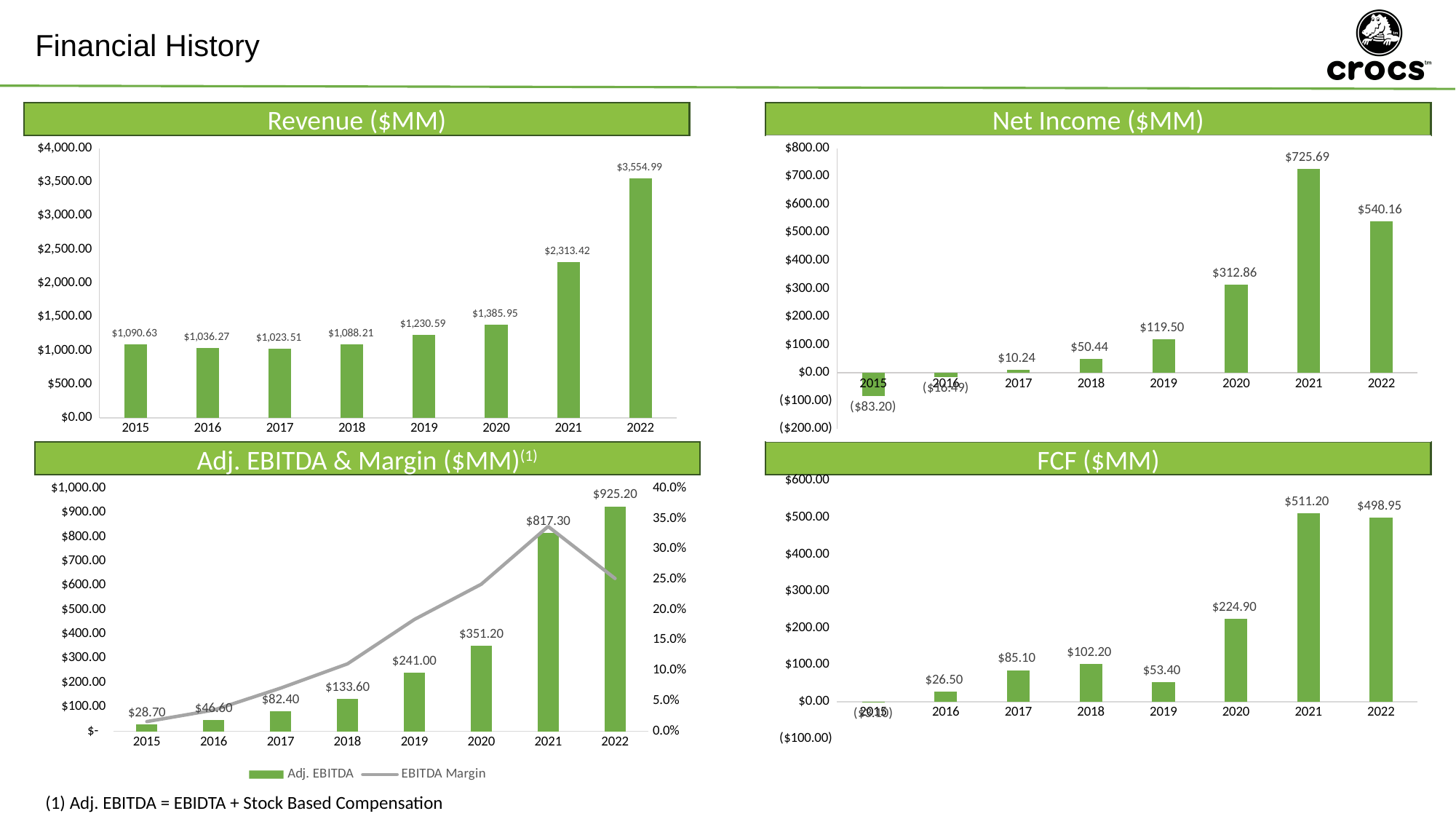
In the Adj. EBITDA & Margin ($MM) chart, what is the Adj. EBITDA for 2019? $241.00 How many years are shown on the x axis of the FCF ($MM) chart? 8 In the Net Income ($MM) chart, what is the net income for 2021? $725.69 In the Net Income ($MM) chart, which year has the highest net income? 2021 In the Adj. EBITDA & Margin ($MM) chart, how many series does the legend list? 2 In the Net Income ($MM) chart, is the value for 2020 greater or less than $300.00? greater In the FCF ($MM) chart, what is the FCF for 2020? $224.90 In the Revenue ($MM) chart, which year has the lowest revenue? 2017 In the FCF ($MM) chart, which is larger, the value for 2021 or the value for 2022? 2021 In the Adj. EBITDA & Margin ($MM) chart, do the Adj. EBITDA bars rise or fall from 2015 to 2022? rise In the Revenue ($MM) chart, what is the revenue for 2022? $3,554.99 In the Revenue ($MM) chart, what is the difference between the 2022 and 2021 values? $1,241.57